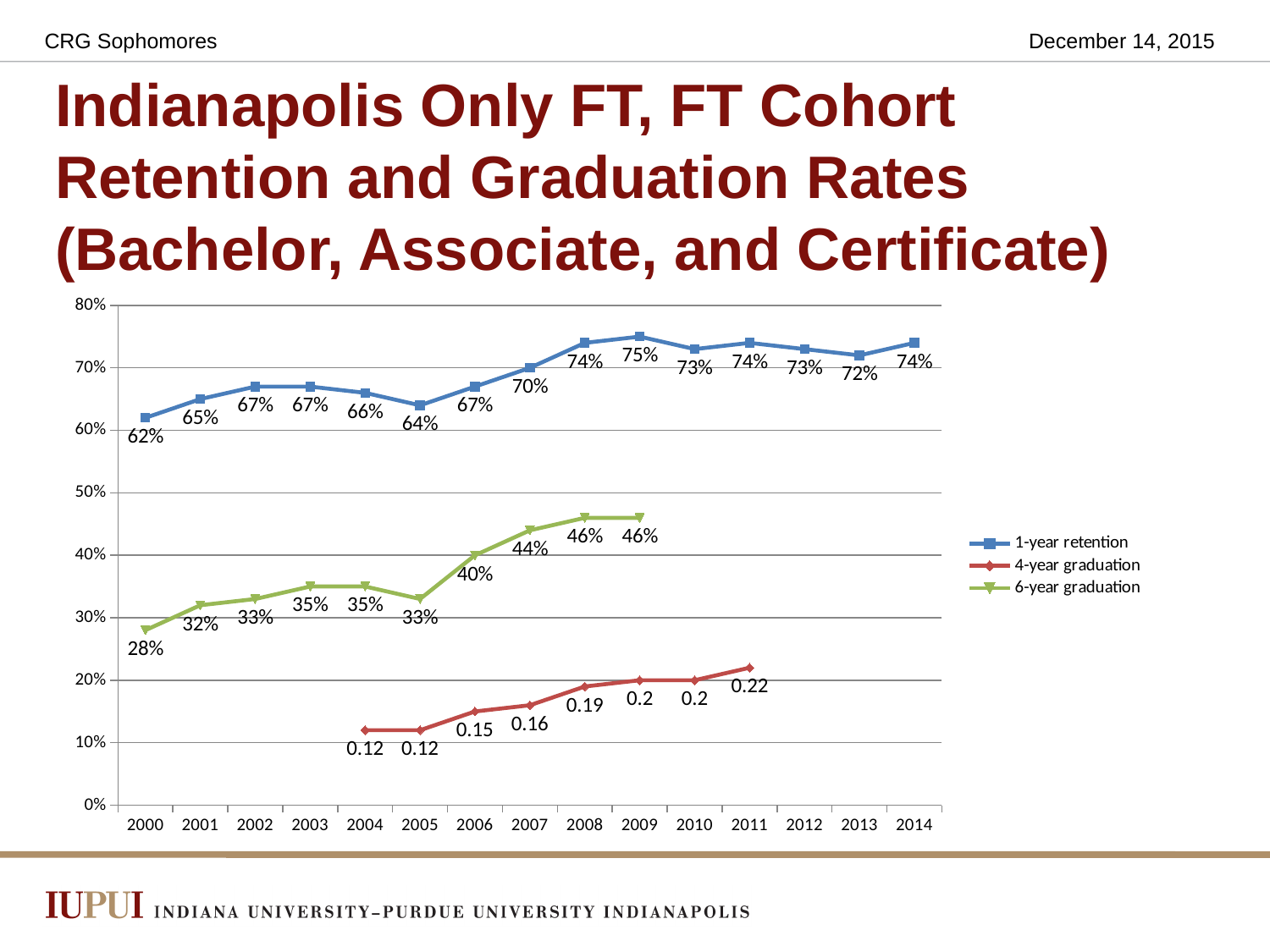
What is the 4-year graduation value shown for the 2011 cohort? 0.22 How many cohort years are shown on the x axis? 15 What is the difference between the 6-year graduation rate for 2009 and for 2000? 18% What is the 6-year graduation rate for the 2000 cohort? 28% Which cohort year has the highest 1-year retention rate? 2009 Which cohort year has the lowest 1-year retention rate? 2000 Which is larger, the 1-year retention rate for 2005 or for 2006? 2006 Which series is drawn in green? 6-year graduation How many series does the legend list? 3 What kind of chart is shown on the slide? Line chart What is the 1-year retention rate for the 2009 cohort? 75% Does the 4-year graduation rate rise or fall from the 2004 cohort to the 2011 cohort? Rise